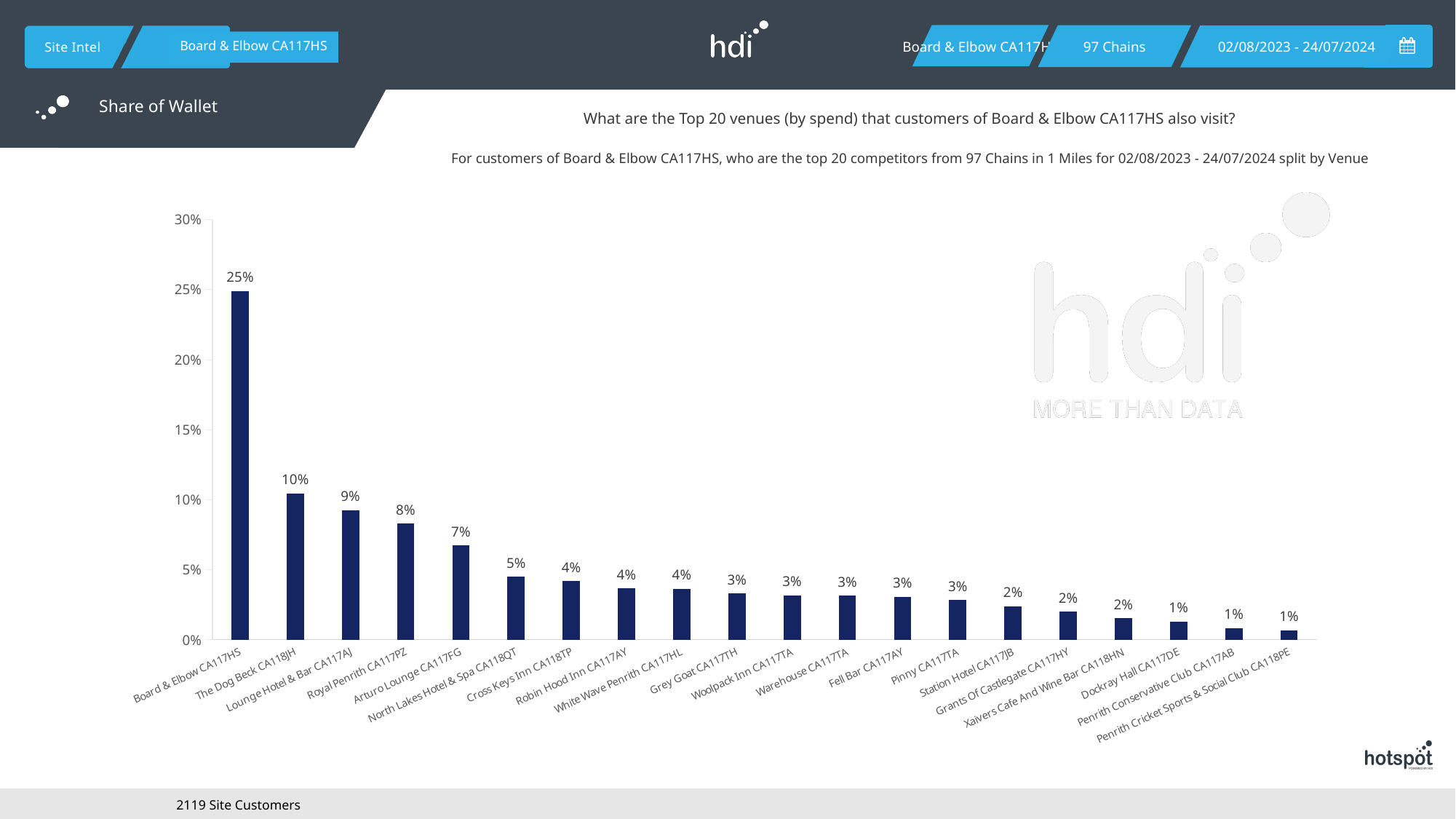
Do the values rise or fall from left to right along the x axis? fall What is the value for North Lakes Hotel & Spa CA118QT? 5% What is the difference between the values for Board & Elbow CA117HS and The Dog Beck CA118JH? 15% Is the value for Board & Elbow CA117HS greater or less than 20%? greater What is the value for Board & Elbow CA117HS? 25% What is the value for The Dog Beck CA118JH? 10% What is the value for Arturo Lounge CA117FG? 7% What is the value for Station Hotel CA117JB? 2% How many venues are plotted on the chart? 20 What kind of chart is shown on the slide? bar chart Which is larger, the value for Lounge Hotel & Bar CA117AJ or the value for Royal Penrith CA117PZ? Lounge Hotel & Bar CA117AJ Which venue has the highest value? Board & Elbow CA117HS